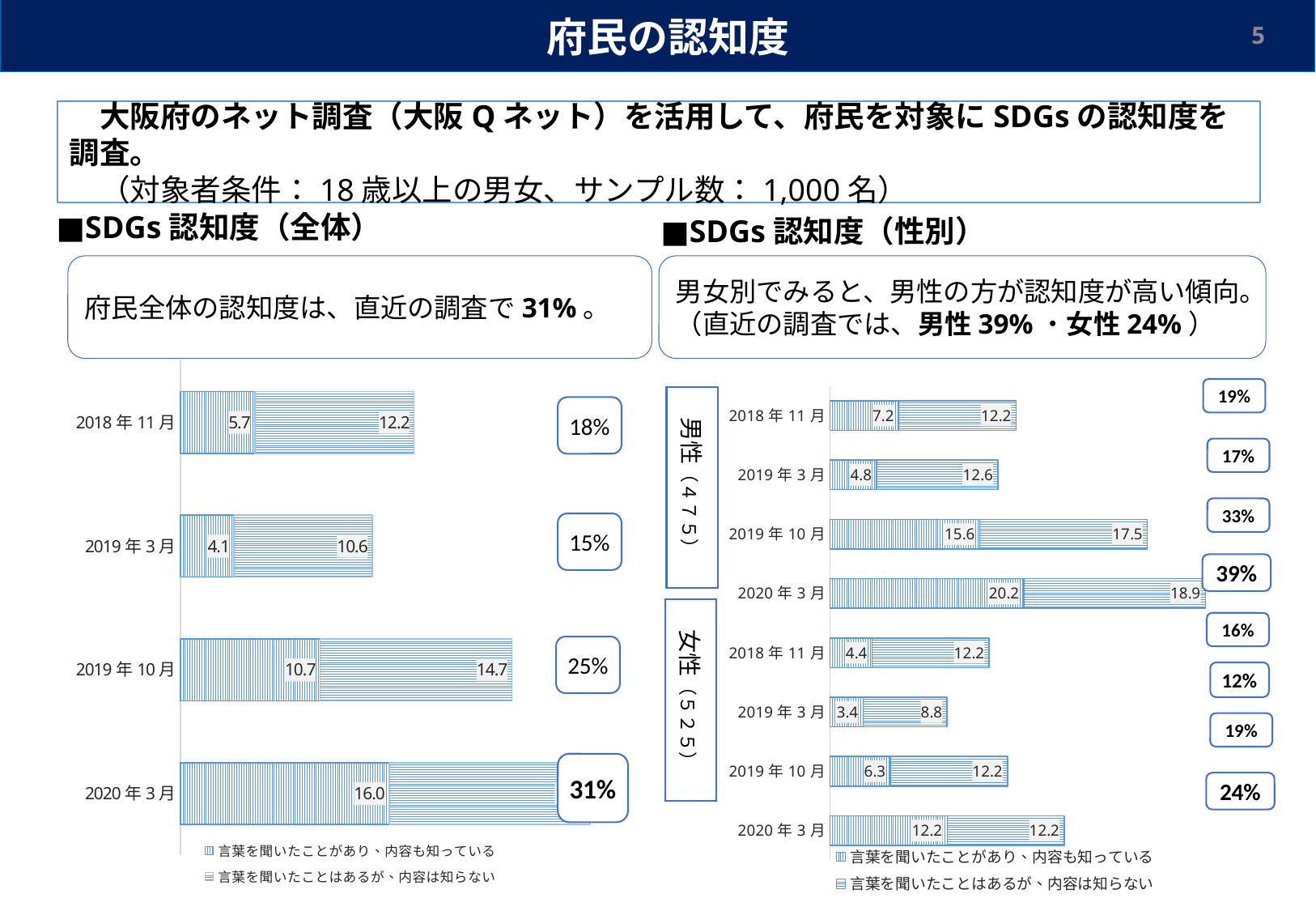
In the SDGs認知度（全体） chart, what is the difference between the 言葉を聞いたことがあり、内容も知っている values for 2020年3月 and 2019年10月? 5.3 In the SDGs認知度（性別） chart, what is the value of 言葉を聞いたことはあるが、内容は知らない for 女性 in 2019年3月? 8.8 In the SDGs認知度（性別） chart, what is the difference between the 言葉を聞いたことがあり、内容も知っている values for 男性 and 女性 in 2018年11月? 2.8 In the SDGs認知度（性別） chart, which 男性 period has the highest value for 言葉を聞いたことがあり、内容も知っている? 2020年3月 How many series does the legend of the SDGs認知度（性別） chart list? 2 In the SDGs認知度（全体） chart, what is the value of 言葉を聞いたことがあり、内容も知っている for 2019年10月? 10.7 In the SDGs認知度（性別） chart, which is larger: the 言葉を聞いたことがあり、内容も知っている value for 男性 in 2019年10月 or for 女性 in 2019年10月? 男性 in 2019年10月 What kind of chart is the SDGs認知度（全体） chart? Stacked bar chart In the SDGs認知度（全体） chart, how many periods are plotted? 4 In the SDGs認知度（全体） chart, which period has the lowest value for 言葉を聞いたことがあり、内容も知っている? 2019年3月 In the SDGs認知度（全体） chart, what is the value of 言葉を聞いたことはあるが、内容は知らない for 2018年11月? 12.2 In the SDGs認知度（性別） chart, what is the value of 言葉を聞いたことがあり、内容も知っている for 男性 in 2020年3月? 20.2